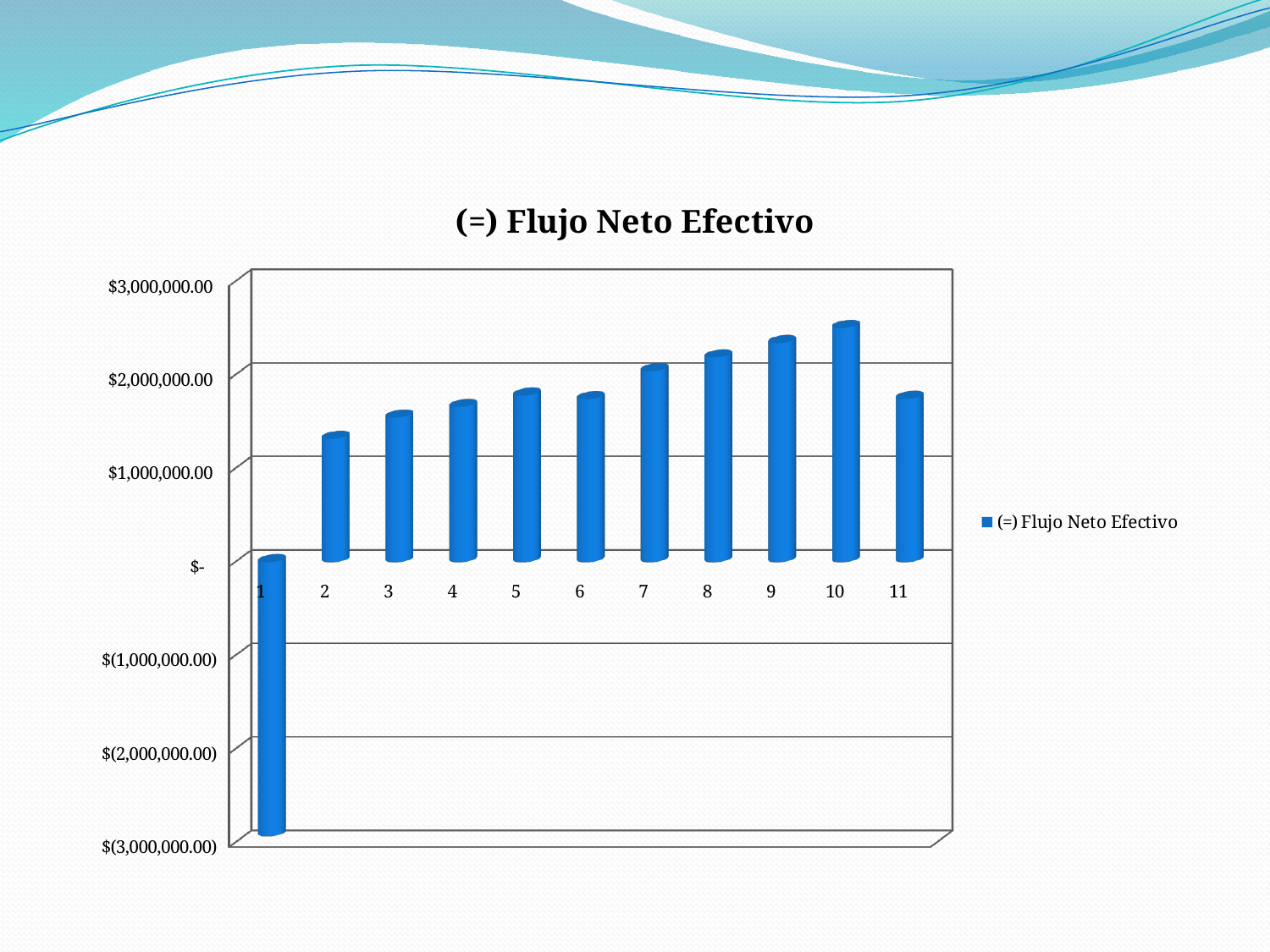
Is the value for category 1 greater or less than $(2,000,000.00)? less How many categories are shown on the x axis of the chart? 11 Which is larger, the value for category 10 or the value for category 2? 10 What kind of chart is shown on the slide? bar chart Which category has the highest value in the chart? 10 Is the value for category 3 greater or less than $2,000,000.00? less Is the value for category 2 greater or less than $1,000,000.00? greater Do the values rise or fall from category 2 to category 10? rise How many series does the legend list? 1 What is the title of the chart? (=) Flujo Neto Efectivo Which category has the lowest value in the chart? 1